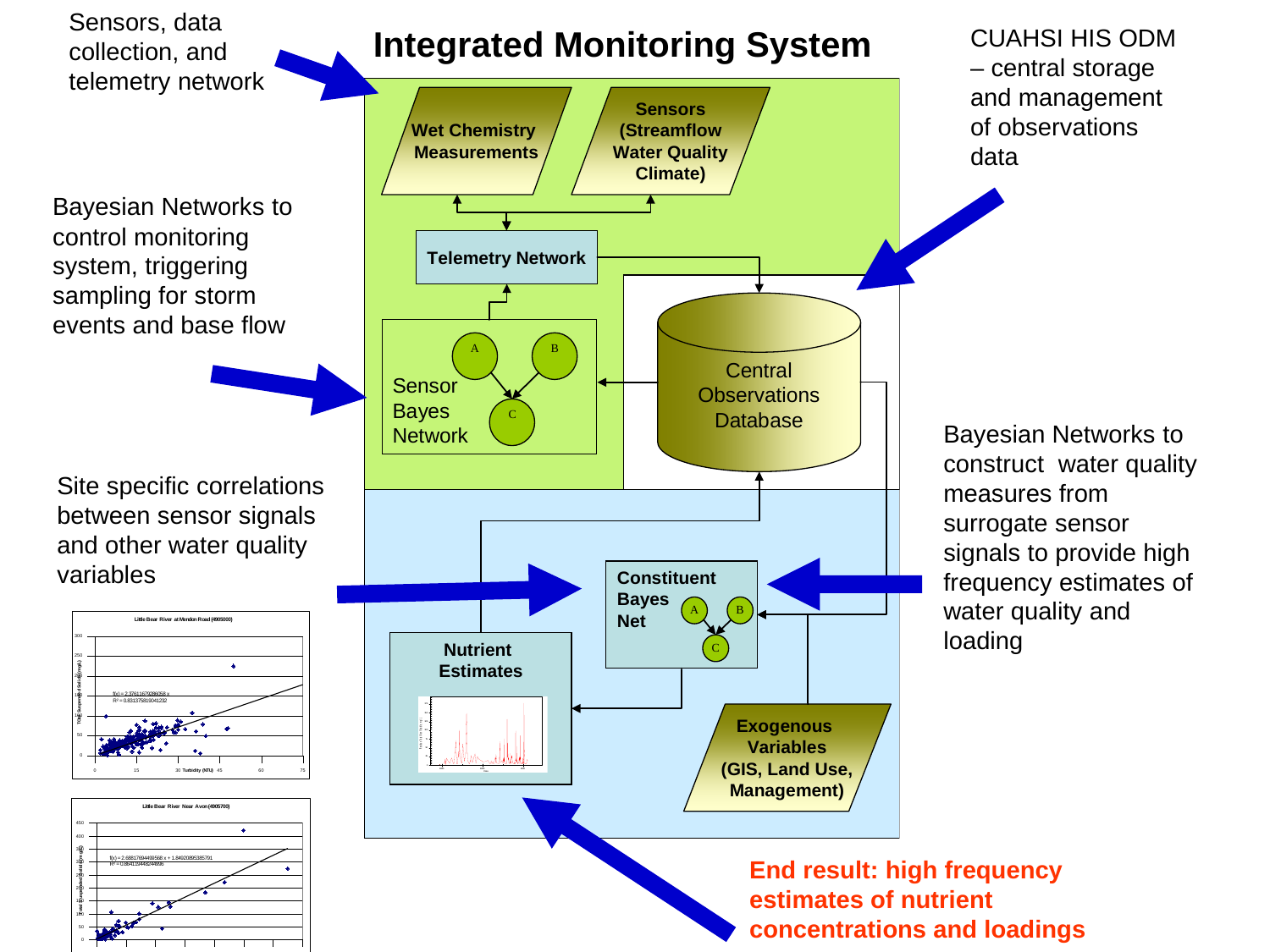
What is the label on the x axis of the 'Little Bear River at Mendon Road (4905000)' chart? Turbidity (NTU) In the 'Little Bear River at Mendon Road (4905000)' chart, do the plotted values rise or fall as turbidity increases along the x axis? rise In the 'Little Bear River Near Avon (4905700)' chart, is the highest plotted point greater or less than 350? greater What kind of chart is the lower chart on the left, titled 'Little Bear River Near Avon (4905700)'? scatter chart What is the highest tick value shown on the y axis of the 'Little Bear River Near Avon (4905700)' chart? 450 In the 'Little Bear River at Mendon Road (4905000)' chart, is the highest plotted point greater or less than 200? greater What kind of chart is the upper chart on the left, titled 'Little Bear River at Mendon Road (4905000)'? scatter chart In the 'Little Bear River Near Avon (4905700)' chart, do the plotted values rise or fall along the x axis? rise In the 'Little Bear River at Mendon Road (4905000)' chart, is the highest plotted point greater or less than 300? less